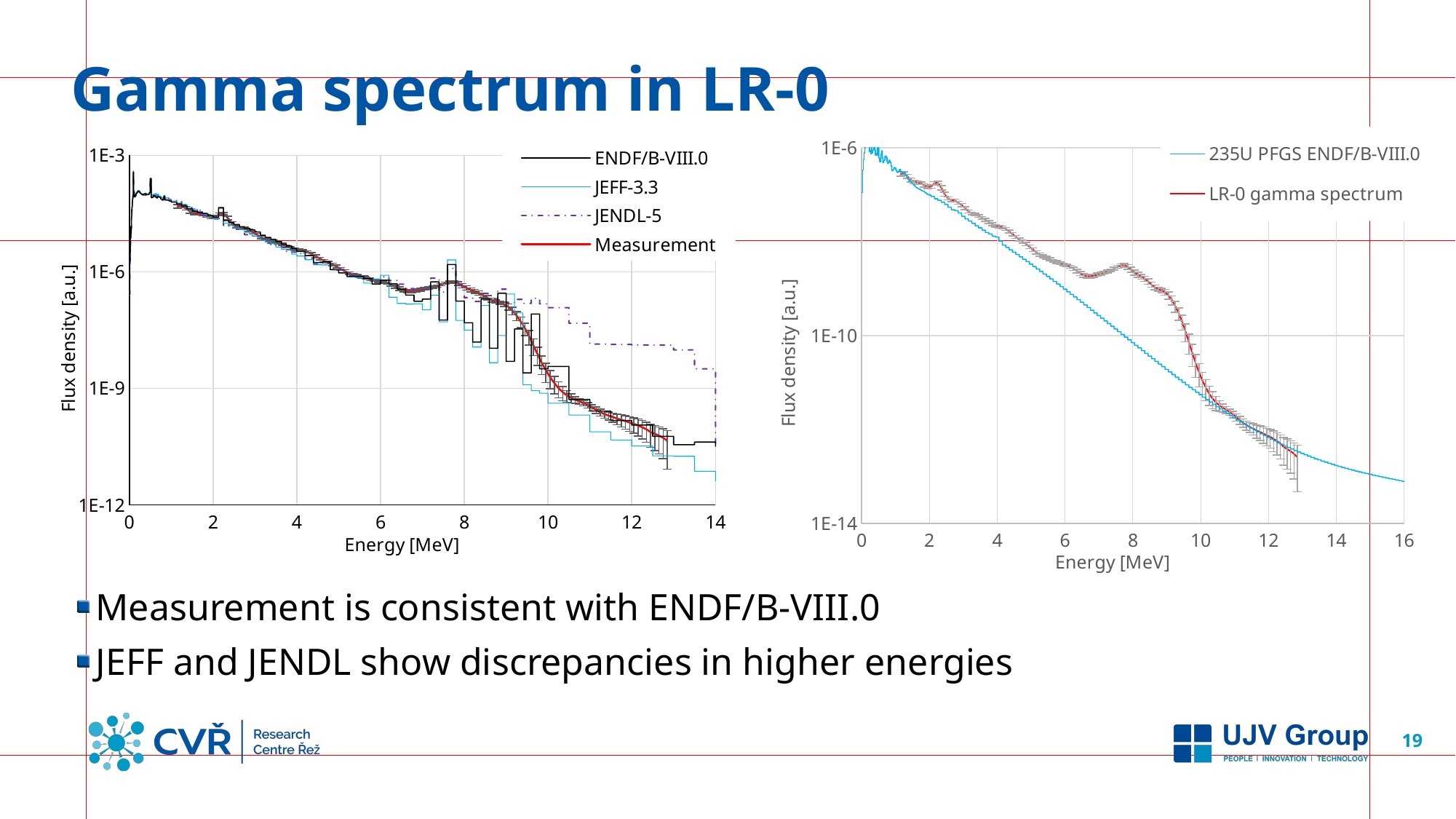
In the left chart, at 12 MeV, which series has the larger value: JENDL-5 or JEFF-3.3? JENDL-5 What kind of chart is the left chart on the slide? Line chart In the left chart, is the JENDL-5 value at 12 MeV greater or less than 1E-9? greater In the left chart, do the flux density values generally rise or fall as energy increases along the x axis? Fall In the right chart, how many series does the legend list? 2 In the right chart, do the flux density values generally rise or fall as energy increases along the x axis? Fall What is the x-axis label of the left chart? Energy [MeV] In the left chart, how many series does the legend list? 4 What kind of chart is the right chart on the slide? Line chart In the left chart, is the JEFF-3.3 value at 12 MeV greater or less than 1E-9? less How many charts are shown on the slide? 2